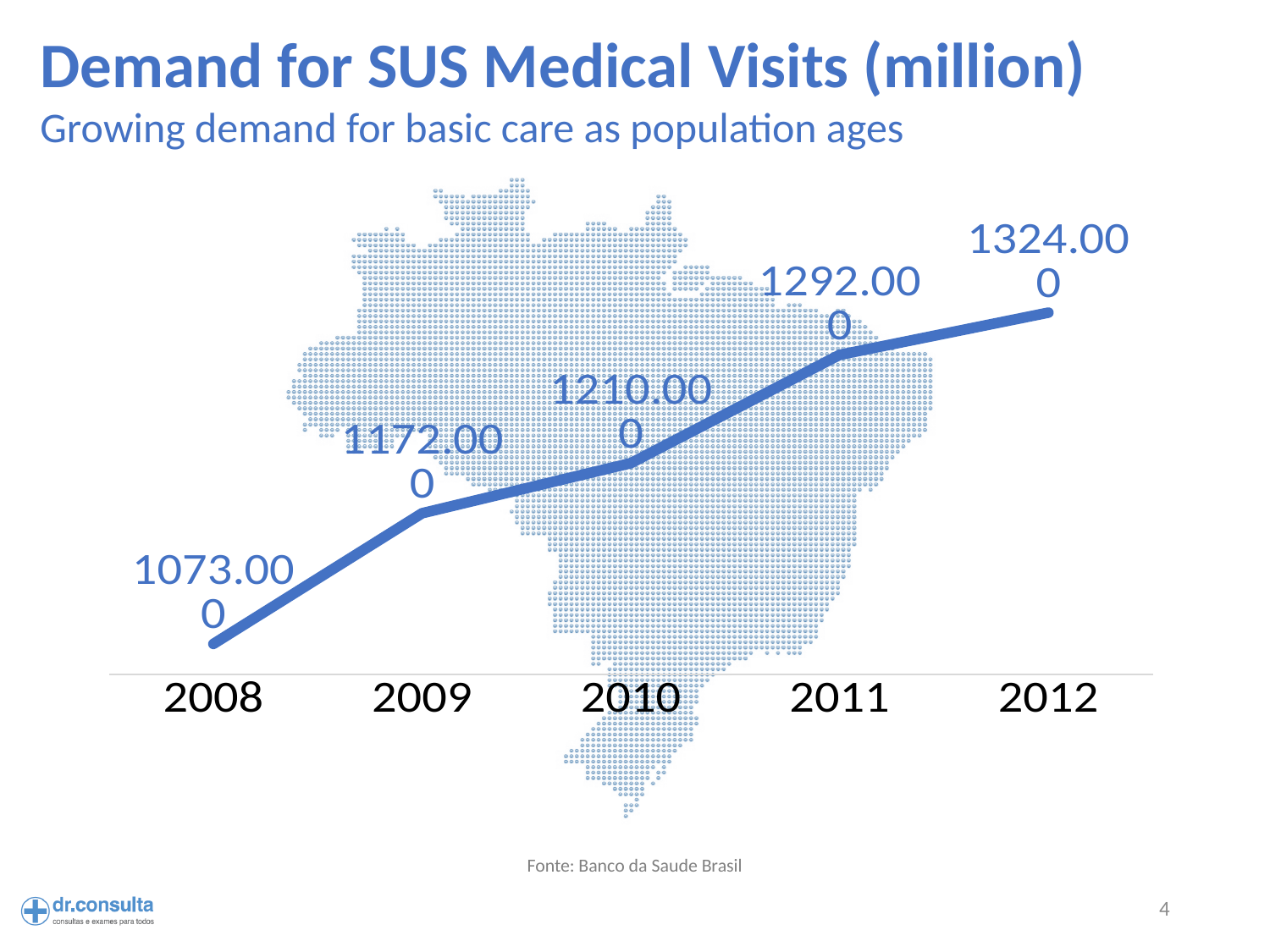
How many years are plotted on the chart? 5 What is the difference between the values for 2009 and 2008? 99.000 What is the value for 2012? 1324.000 What kind of chart is shown on the slide? line chart What is the value for 2011? 1292.000 Which year has the highest value? 2012 What is the value for 2008? 1073.000 What is the difference between the values for 2012 and 2008? 251.000 Which year has the lowest value? 2008 Do the values rise or fall from 2008 to 2012? rise What is the value for 2010? 1210.000 Which is larger, the value for 2011 or the value for 2010? 2011